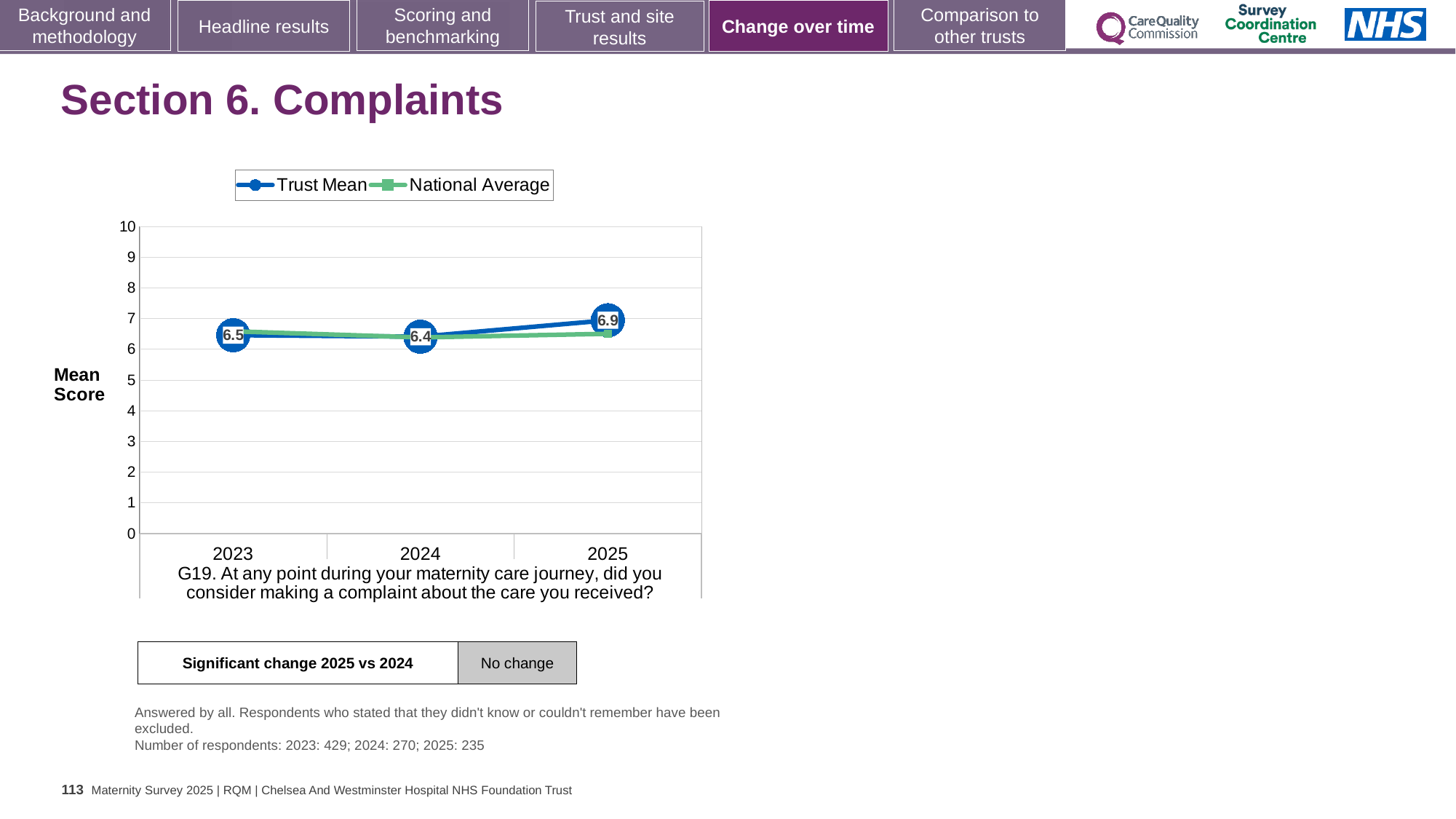
What kind of chart is shown on the slide? line chart Which is larger, the Trust Mean score in 2025 or in 2023? 2025 How many series does the chart legend list? 2 Does the Trust Mean score rise or fall from 2024 to 2025? rise In which year is the Trust Mean score lowest? 2024 Is the National Average value for 2025 greater or less than 7? less What is the Trust Mean score for 2025? 6.9 What is the difference between the Trust Mean score in 2025 and in 2024? 0.5 What is the Trust Mean score for 2023? 6.5 How many years are shown on the x axis of the chart? 3 What is the Trust Mean score for 2024? 6.4 In which year is the Trust Mean score highest? 2025